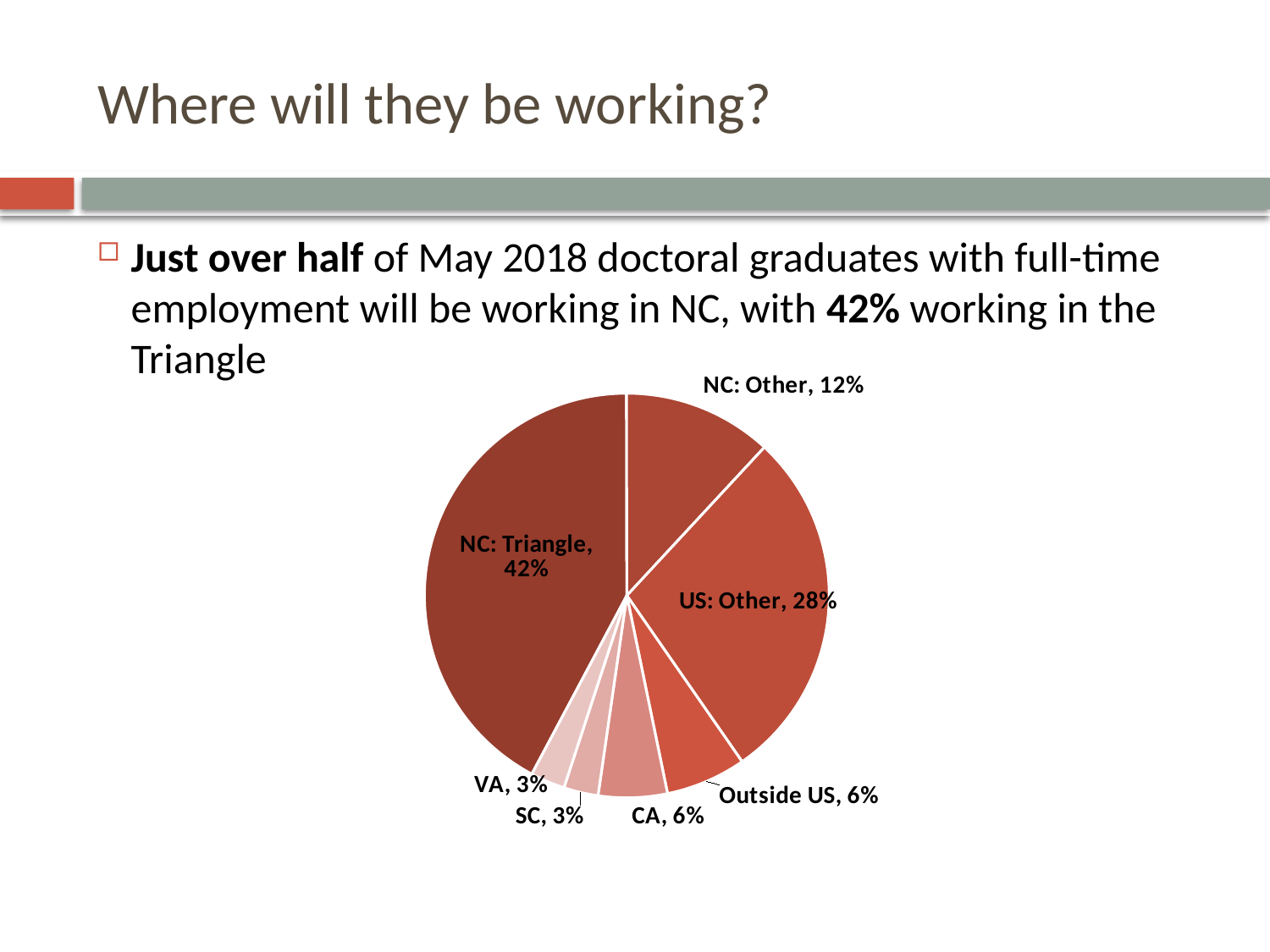
What is the value for NC: Other? 12% What is the combined share of NC: Triangle and NC: Other? 54% What is the title of the slide containing the chart? Where will they be working? What is the value for Outside US? 6% What is the value for VA? 3% How many slices does the pie chart have? 7 What is the difference between the NC: Triangle share and the US: Other share? 14% Which is larger, NC: Other or CA? NC: Other Which slice of the pie is the largest? NC: Triangle What share of the pie is NC: Triangle? 42% What kind of chart is shown on the slide? pie chart What share of the pie is US: Other? 28%